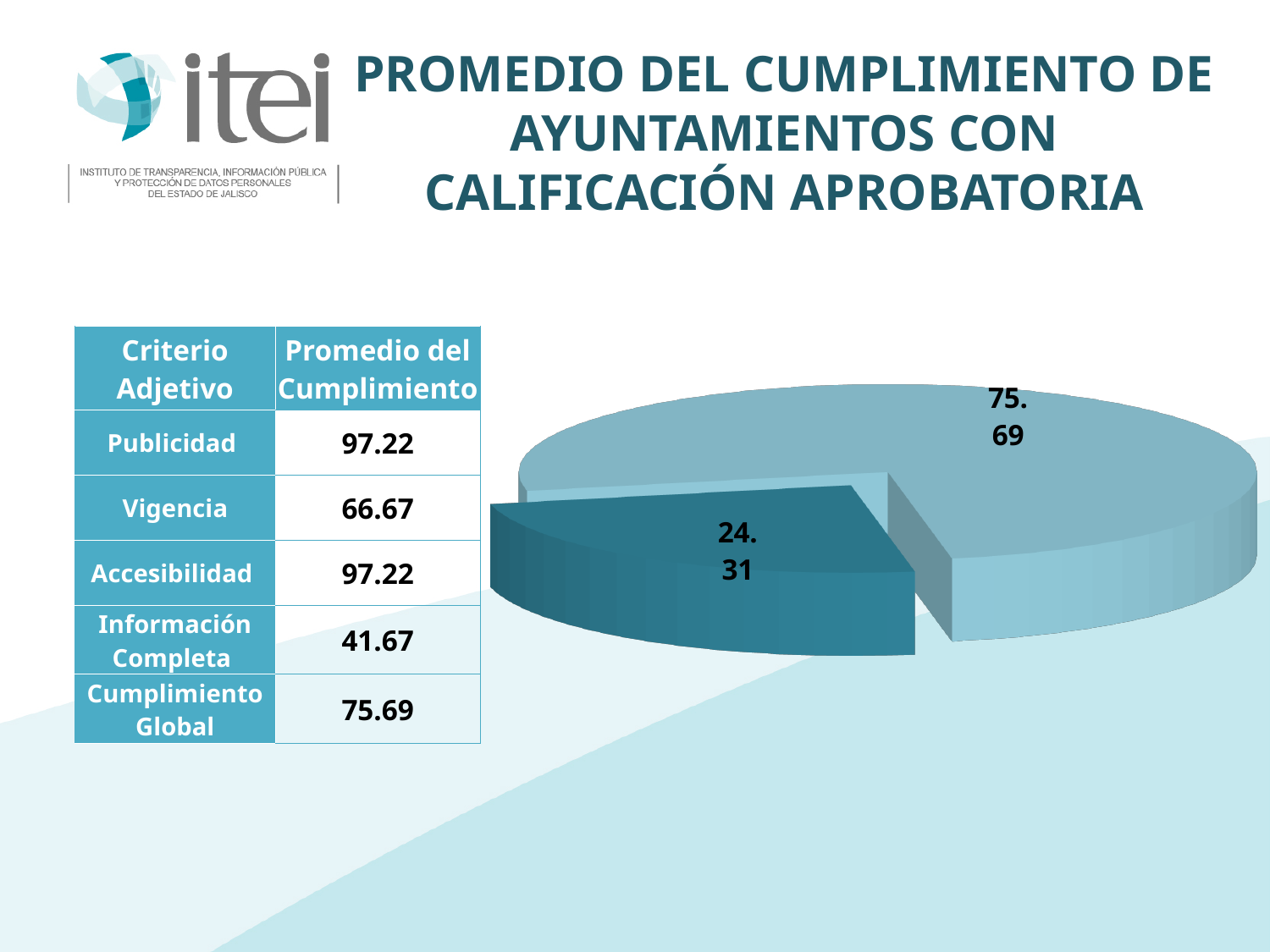
Is the value printed on the dark teal slice of the pie chart larger or smaller than the value on the light-blue slice? smaller Does the pie chart have a legend? No What kind of chart is shown on the slide? pie chart What value is printed on the larger, light-blue slice of the pie chart? 75.69 What is the difference between the two values printed on the pie chart, 75.69 and 24.31? 51.38 Which slice of the pie chart is pulled out (exploded) from the rest of the pie? the dark teal slice labelled 24.31 How many slices does the pie chart have? 2 Which slice of the pie chart is the largest, the light-blue one or the dark teal one? the light-blue one What value is printed on the smaller, dark teal slice of the pie chart? 24.31 Which slice of the pie chart is the smallest, the light-blue one or the dark teal one? the dark teal one What is the total of the two values printed on the pie chart? 100